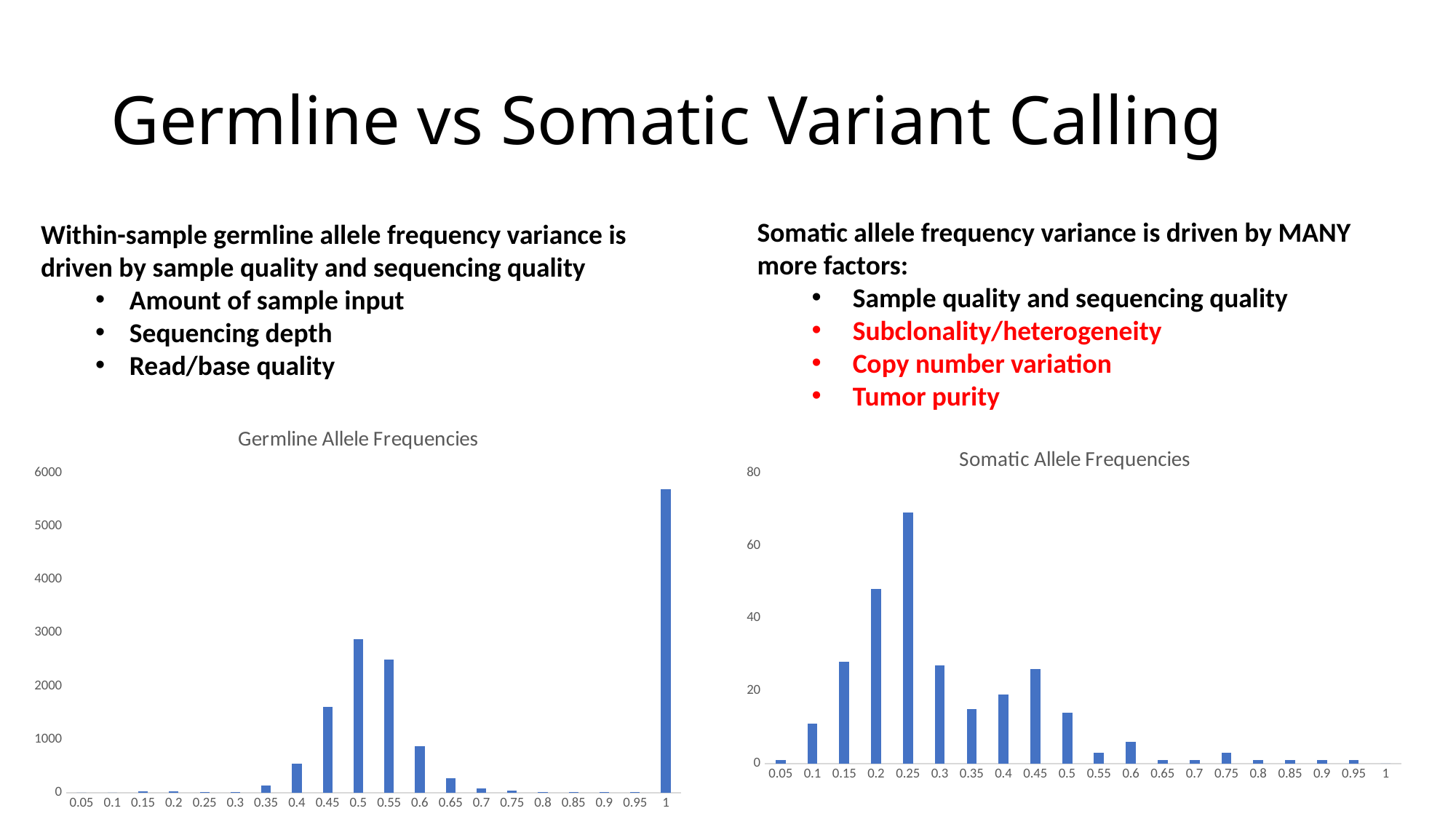
In the Germline Allele Frequencies chart, is the value for 0.6 greater or less than 1000? less In the Somatic Allele Frequencies chart, is the value for 0.25 greater or less than 60? greater In the Germline Allele Frequencies chart, is the value for 0.55 greater or less than 2000? greater What type of chart is the Germline Allele Frequencies chart? bar chart How many allele frequency bins are shown on the x axis of the Somatic Allele Frequencies chart? 20 In the Germline Allele Frequencies chart, which allele frequency bin has the highest bar? 1 In the Somatic Allele Frequencies chart, which bin has the larger value, 0.2 or 0.3? 0.2 In the Germline Allele Frequencies chart, which bin has the larger value, 0.5 or 0.55? 0.5 In the Somatic Allele Frequencies chart, which allele frequency bin has the highest bar? 0.25